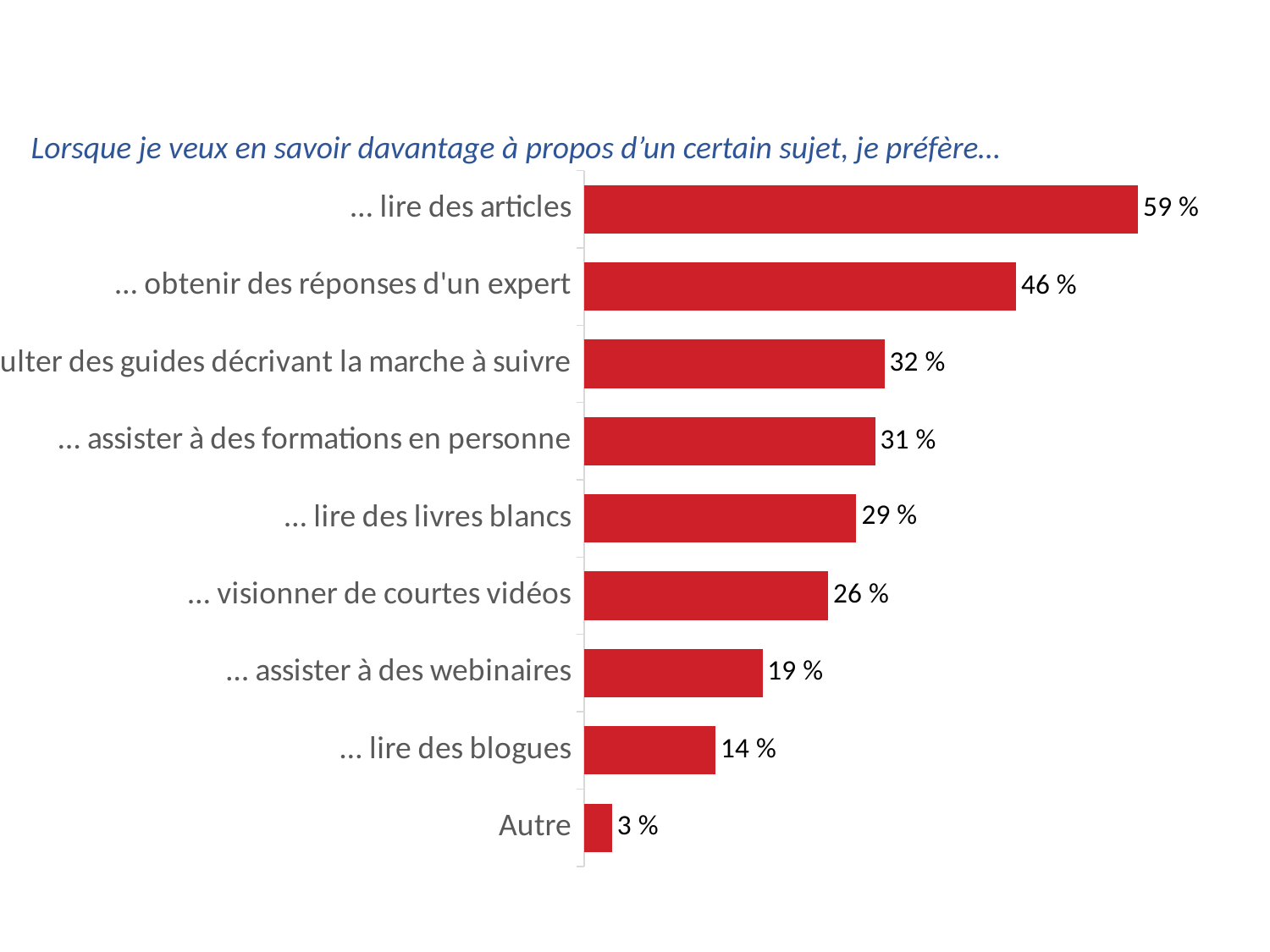
What is the difference between "… lire des livres blancs" and "… lire des blogues"? 15 % What colour are the bars in the chart? Red What kind of chart is shown on the slide? Bar chart Which category has the lowest value? Autre What is the value for "… lire des articles"? 59 % What is the value for "… visionner de courtes vidéos"? 26 % Which is larger: "… assister à des formations en personne" or "… visionner de courtes vidéos"? … assister à des formations en personne What is the value for "… assister à des webinaires"? 19 % What is the difference between "… lire des articles" and "… obtenir des réponses d'un expert"? 13 % How many categories are shown in the chart? 9 What is the value for "Autre"? 3 % Which category has the highest value? … lire des articles